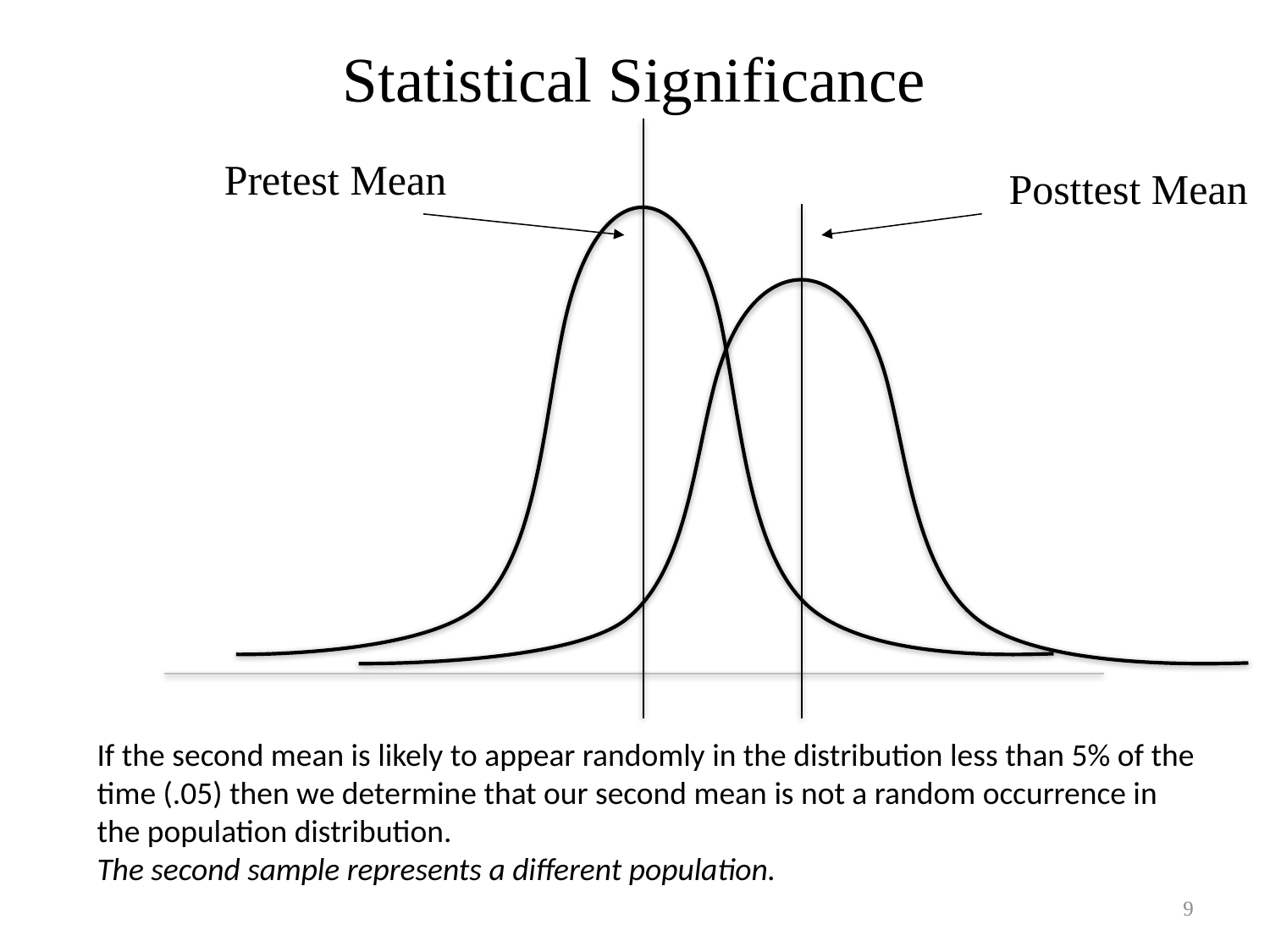
Do the two curves on the chart overlap? Yes Which mean is positioned further to the left on the chart, the Pretest Mean or the Posttest Mean? Pretest Mean Which mean is positioned further to the right on the chart, the Pretest Mean or the Posttest Mean? Posttest Mean How many vertical mean lines are drawn on the chart? 2 What are the two labels attached by arrows to the vertical lines on the chart? Pretest Mean and Posttest Mean What kind of chart is shown on the slide? Two bell curves (normal distribution curves) What is the title of the chart on the slide? Statistical Significance Which curve reaches the higher peak, the one at the Pretest Mean or the one at the Posttest Mean? Pretest Mean How many distribution curves are drawn on the chart? 2